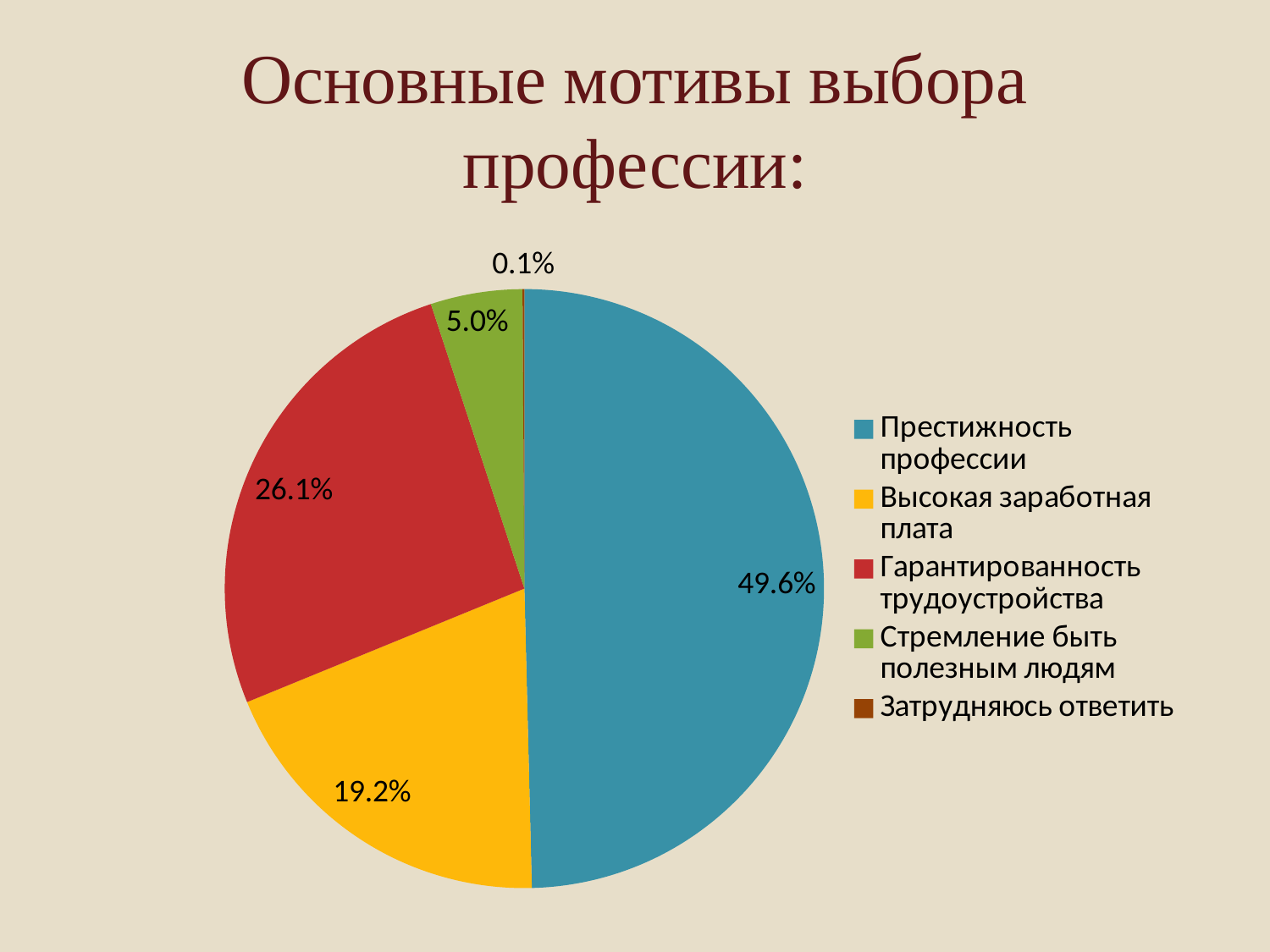
What kind of chart is shown on the slide? pie chart What is the value for "Стремление быть полезным людям"? 5.0% What share of the pie does "Престижность профессии" have? 49.6% What is the difference between the values for "Гарантированность трудоустройства" and "Высокая заработная плата"? 6.9% What is the value for "Высокая заработная плата"? 19.2% What is the value for "Затрудняюсь ответить"? 0.1% Which is larger: "Высокая заработная плата" or "Гарантированность трудоустройства"? Гарантированность трудоустройства What is the value for "Гарантированность трудоустройства"? 26.1% Which category has the smallest slice of the pie? Затрудняюсь ответить Which category has the largest slice of the pie? Престижность профессии How many categories does the legend list? 5 What is the title of the chart on the slide? Основные мотивы выбора профессии: